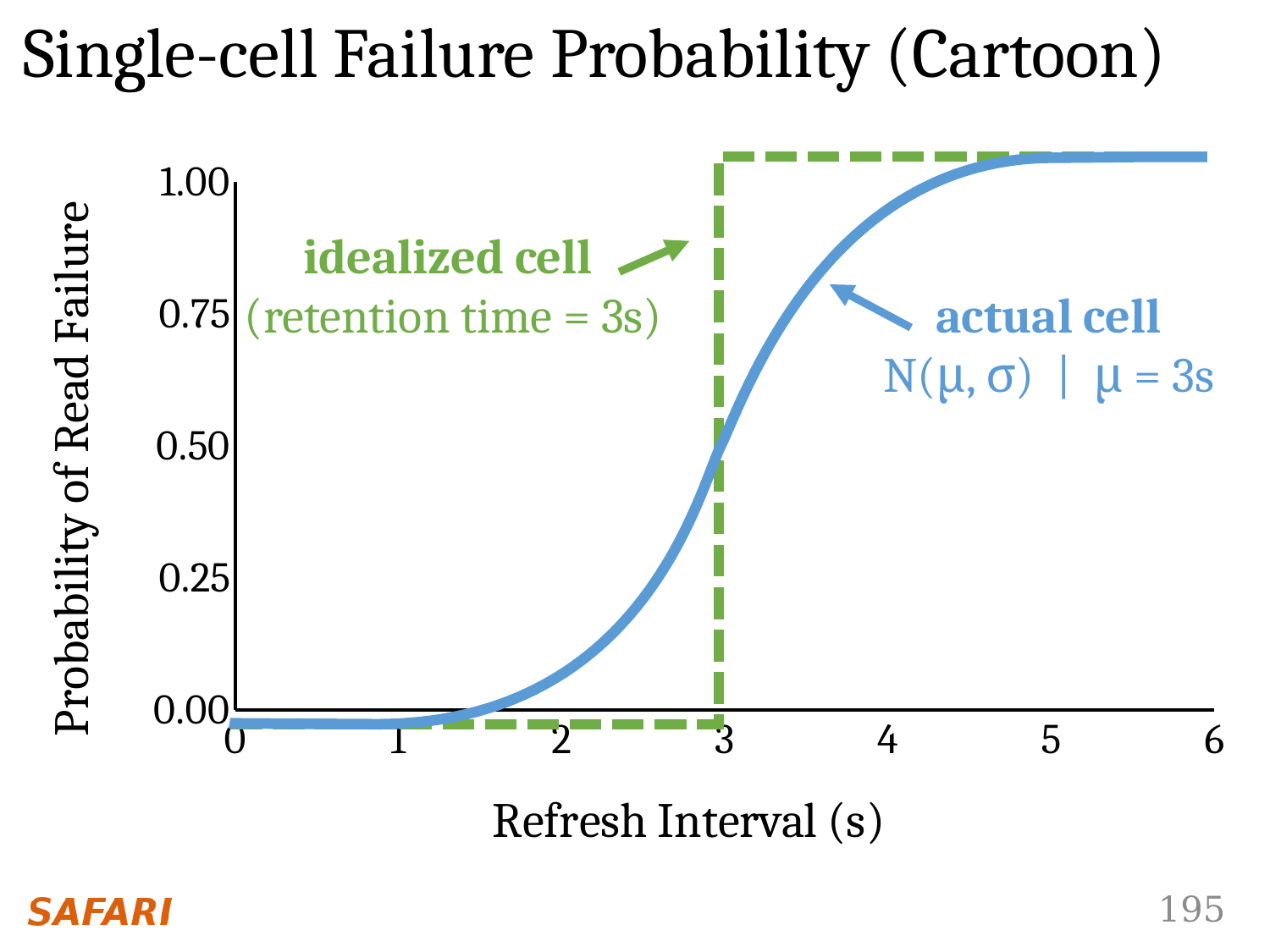
Is the probability of read failure for the actual cell at a refresh interval of 4 s greater or less than 0.75? greater At a refresh interval of 2.5 s, which curve shows the higher probability of read failure, the idealized cell or the actual cell? actual cell Is the probability of read failure for the idealized cell at a refresh interval of 2 s greater or less than 0.25? less Is the probability of read failure for the actual cell at a refresh interval of 2 s greater or less than 0.25? less How many tick marks are labeled on the x axis? 7 What is the label of the x axis? Refresh Interval (s) What kind of chart is shown on the slide? line chart Does the probability of read failure for the actual cell rise or fall as the refresh interval increases? rise How many curves (series) are plotted on the chart? 2 What is the title of the chart on the slide? Single-cell Failure Probability (Cartoon) At a refresh interval of 3.5 s, which curve shows the higher probability of read failure, the idealized cell or the actual cell? idealized cell